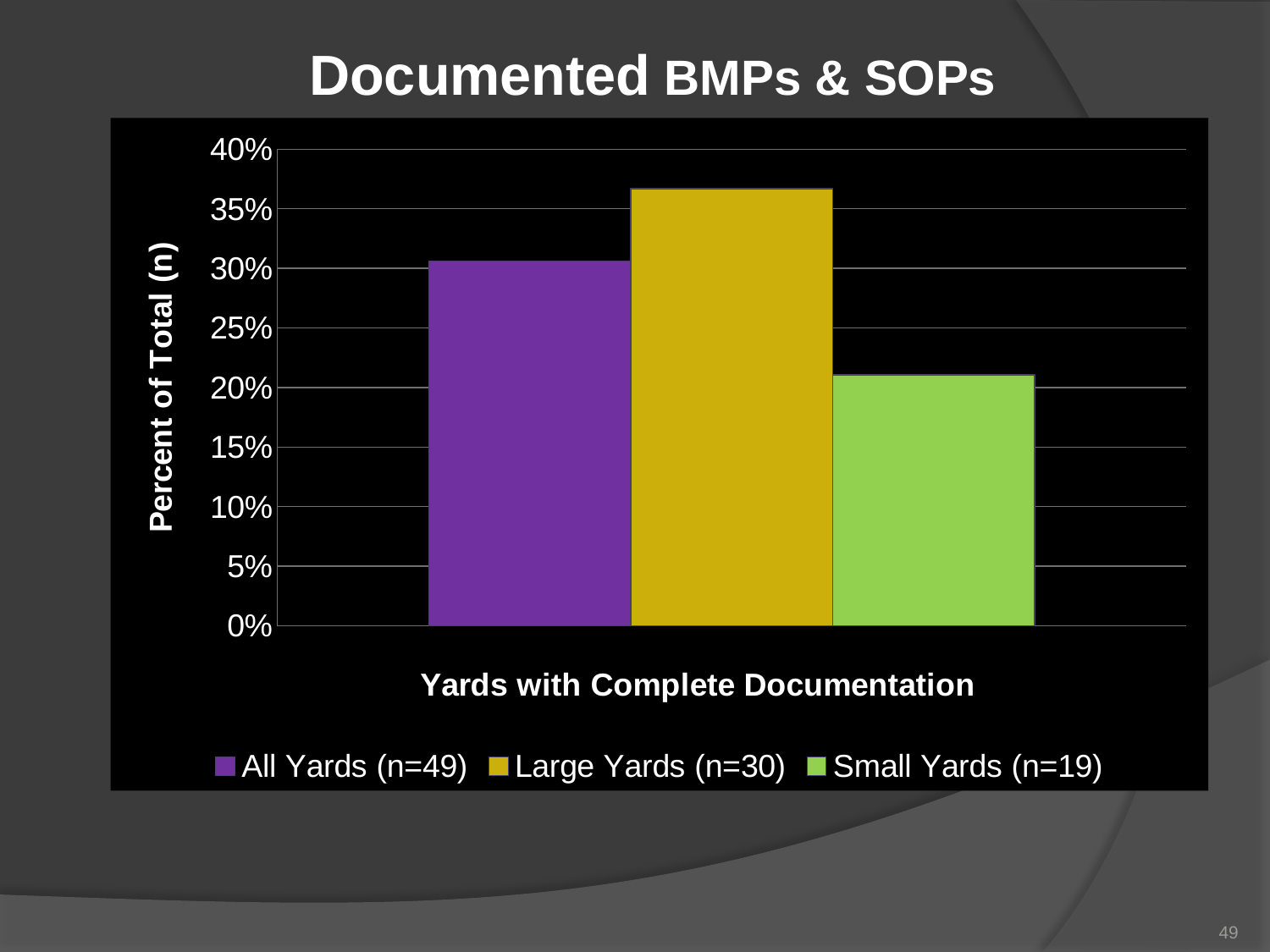
Is the value for Large Yards (n=30) greater or less than 30%? greater What is the label of the y axis? Percent of Total (n) Is the value for All Yards (n=49) greater or less than 25%? greater Which is larger, the value for Large Yards (n=30) or the value for All Yards (n=49)? Large Yards (n=30) What is the category label shown on the x axis? Yards with Complete Documentation Is the value for Small Yards (n=19) greater or less than 25%? less Which is larger, the value for All Yards (n=49) or the value for Small Yards (n=19)? All Yards (n=49) Which series has the highest bar? Large Yards (n=30) What kind of chart is shown on the slide? bar chart How many series does the legend list? 3 Which series has the lowest bar? Small Yards (n=19) How many categories are shown on the x axis? 1